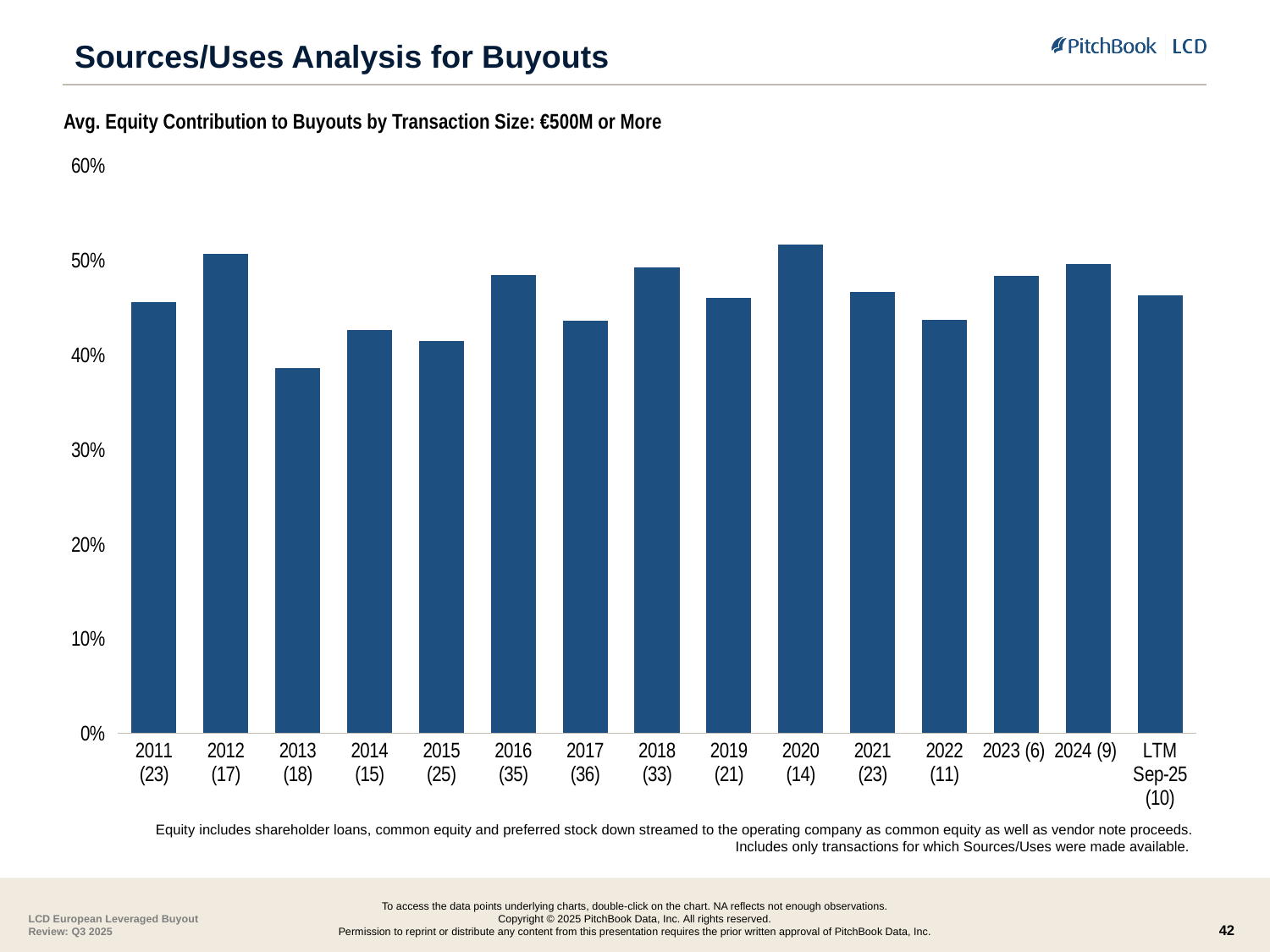
Is the value for 2013 greater or less than 40%? less Which period has the lowest average equity contribution? 2013 (18) Is the value for 2016 greater or less than 50%? less What is the title of the chart? Avg. Equity Contribution to Buyouts by Transaction Size: €500M or More Which is larger, the value for 2017 or the value for 2018? 2018 What kind of chart is shown on the slide? Bar chart Is the value for 2020 greater or less than 50%? greater What number appears in parentheses under the 2011 label on the x axis? 23 Which is larger, the value for 2013 or the value for 2014? 2014 How many bars (periods) are plotted in the chart? 15 Which period has the highest average equity contribution? 2020 (14)